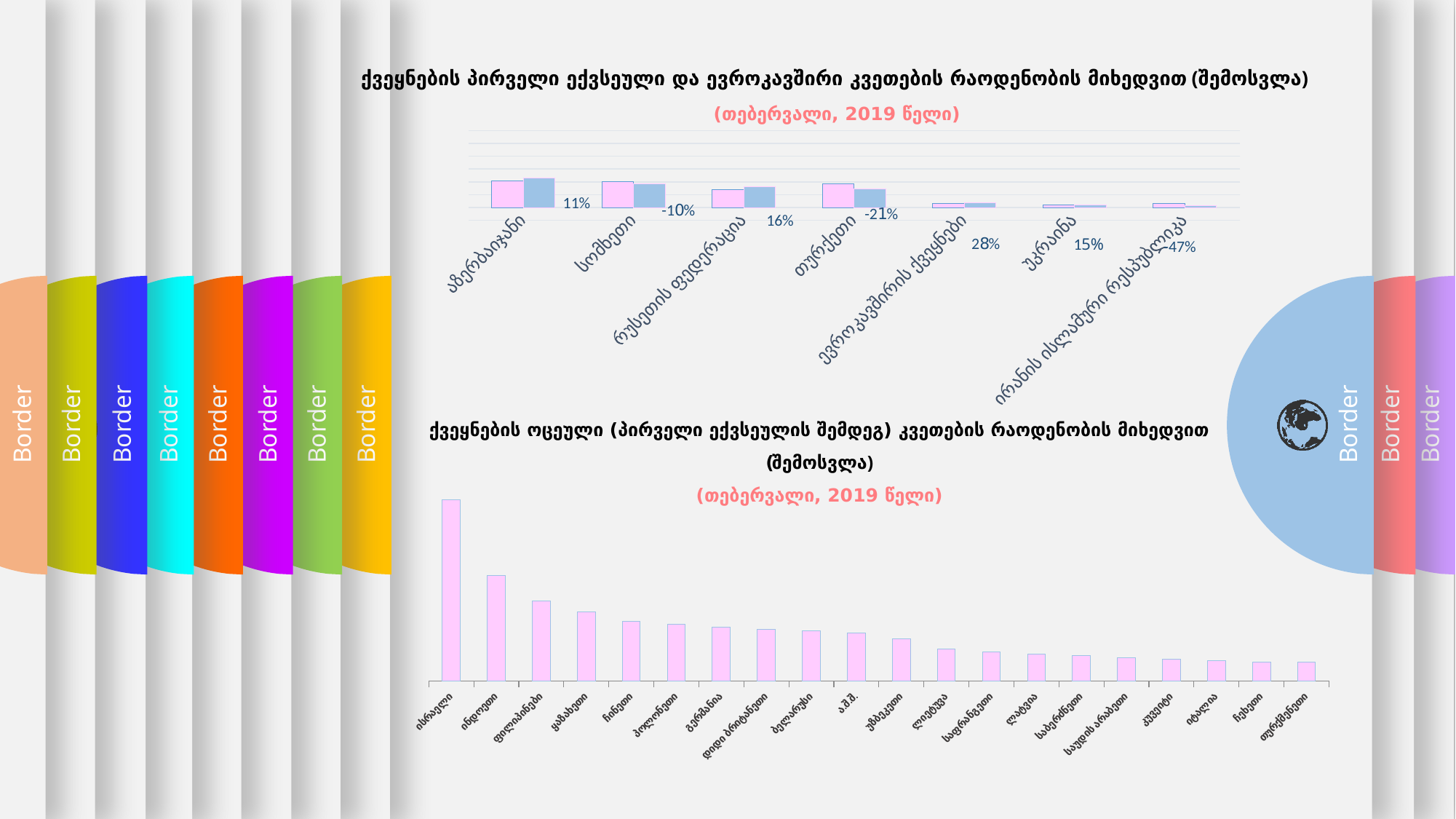
In the bottom chart, how many countries are shown on the x axis? 20 In the bottom chart, which bar is taller: ინდოეთი or ფილიპინები? ინდოეთი In the top chart, how many categories are shown on the x axis? 7 In the bottom chart, do the bar values generally rise or fall from left to right? fall In the top chart, which category has the highest percentage label? ევროკავშირის ქვეყნები In the top chart, what percentage label is shown for აზერბაიჯანი? 11% In the top chart, what percentage label is shown for თურქეთი? -21% What kind of chart is the bottom chart? bar chart In the top chart, which category has the lowest percentage label? ირანის ისლამური რესპუბლიკა In the bottom chart, which country has the tallest bar? ისრაელი In the top chart, what percentage label is shown for ევროკავშირის ქვეყნები? 28% In the top chart, what percentage label is shown for ირანის ისლამური რესპუბლიკა? -47%